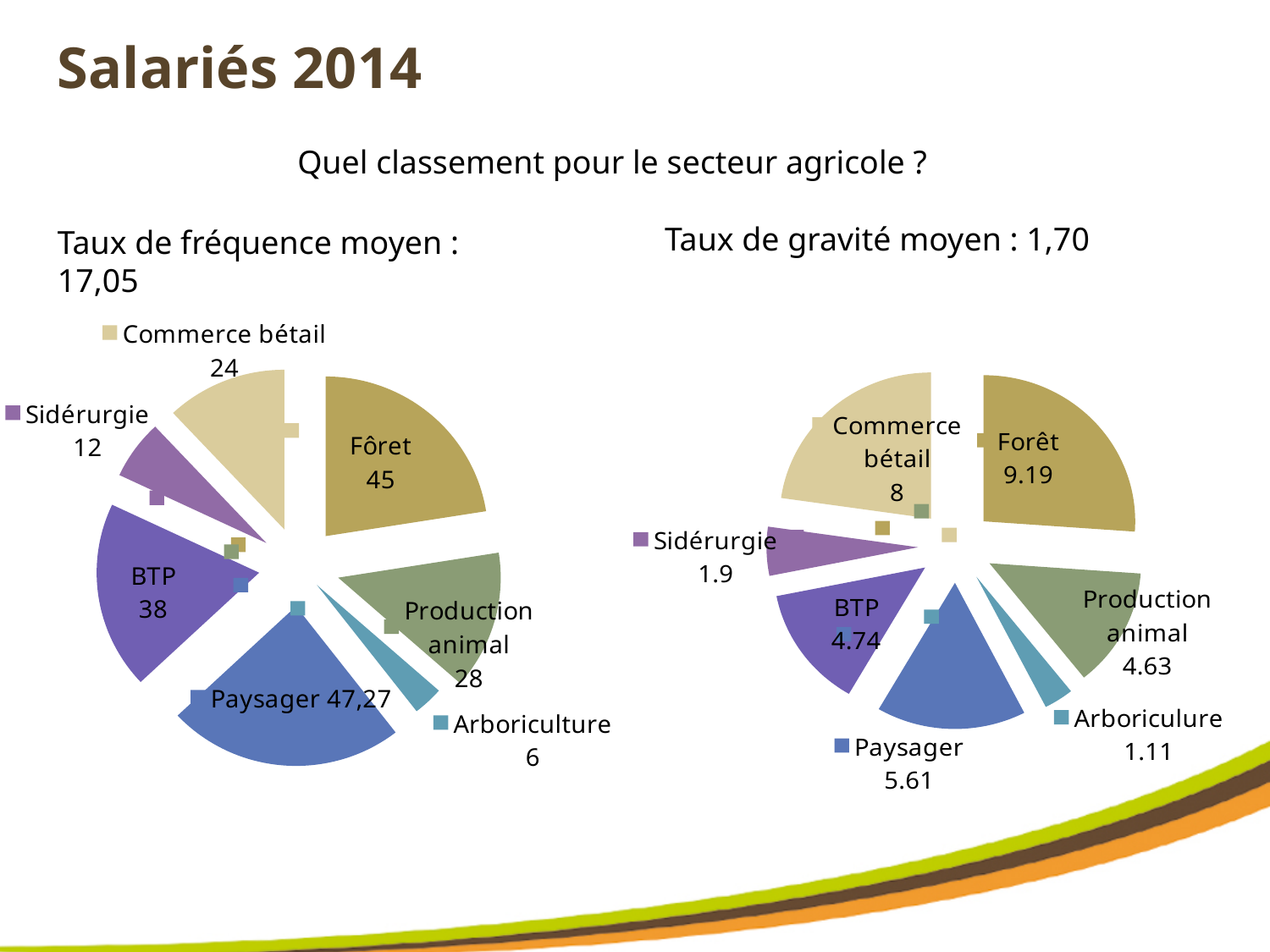
In the right pie chart (Taux de gravité moyen), which category has the highest value? Forêt In the left pie chart (Taux de fréquence moyen), what is the value for BTP? 38 In the left pie chart (Taux de fréquence moyen), what is the value for Paysager? 47,27 In the right pie chart (Taux de gravité moyen), what is the value for Production animal? 4.63 In the right pie chart (Taux de gravité moyen), which is larger: Paysager or Sidérurgie? Paysager What type of chart is used on the left side of the slide (Taux de fréquence moyen)? Pie chart How many slices does the left pie chart (Taux de fréquence moyen) have? 7 In the left pie chart (Taux de fréquence moyen), which category has the lowest value? Arboriculture In the right pie chart (Taux de gravité moyen), which category has the lowest value? Arboriculure In the right pie chart (Taux de gravité moyen), what is the difference between Forêt and Commerce bétail? 1.19 In the left pie chart (Taux de fréquence moyen), what is the difference between Fôret and BTP? 7 In the left pie chart (Taux de fréquence moyen), which category has the highest value? Paysager